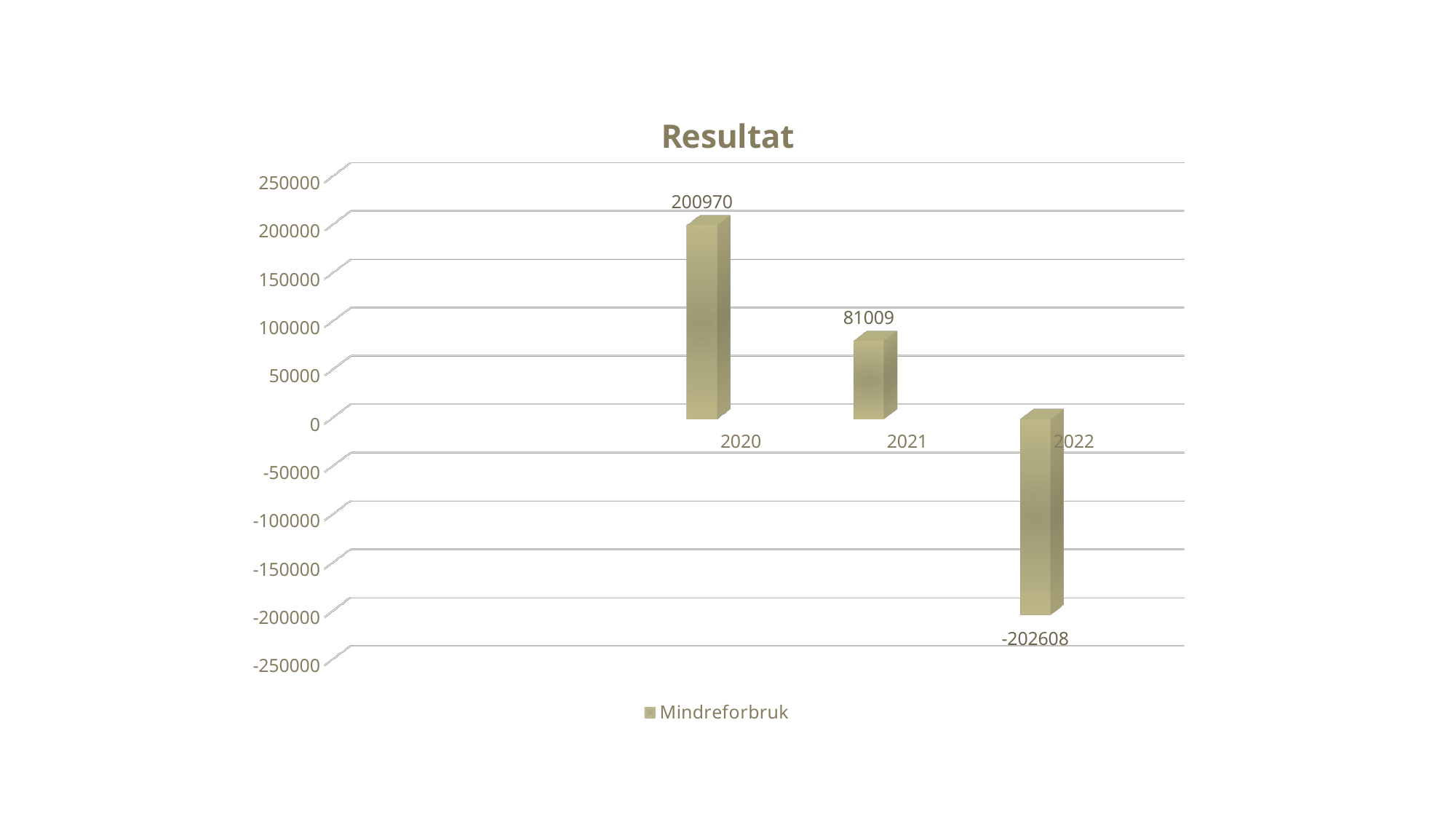
What kind of chart is shown? bar chart Do the values rise or fall from 2020 to 2022? fall What is the value for 2020? 200970 Which year has the lowest value? 2022 Which is larger, the value for 2021 or the value for 2022? 2021 What is the value for 2022? -202608 Is the value for 2021 greater or less than 100000? less Which year has the highest value? 2020 How many series does the legend list? 1 What is the value for 2021? 81009 What is the difference between the values for 2020 and 2021? 119961 How many years are shown on the chart? 3